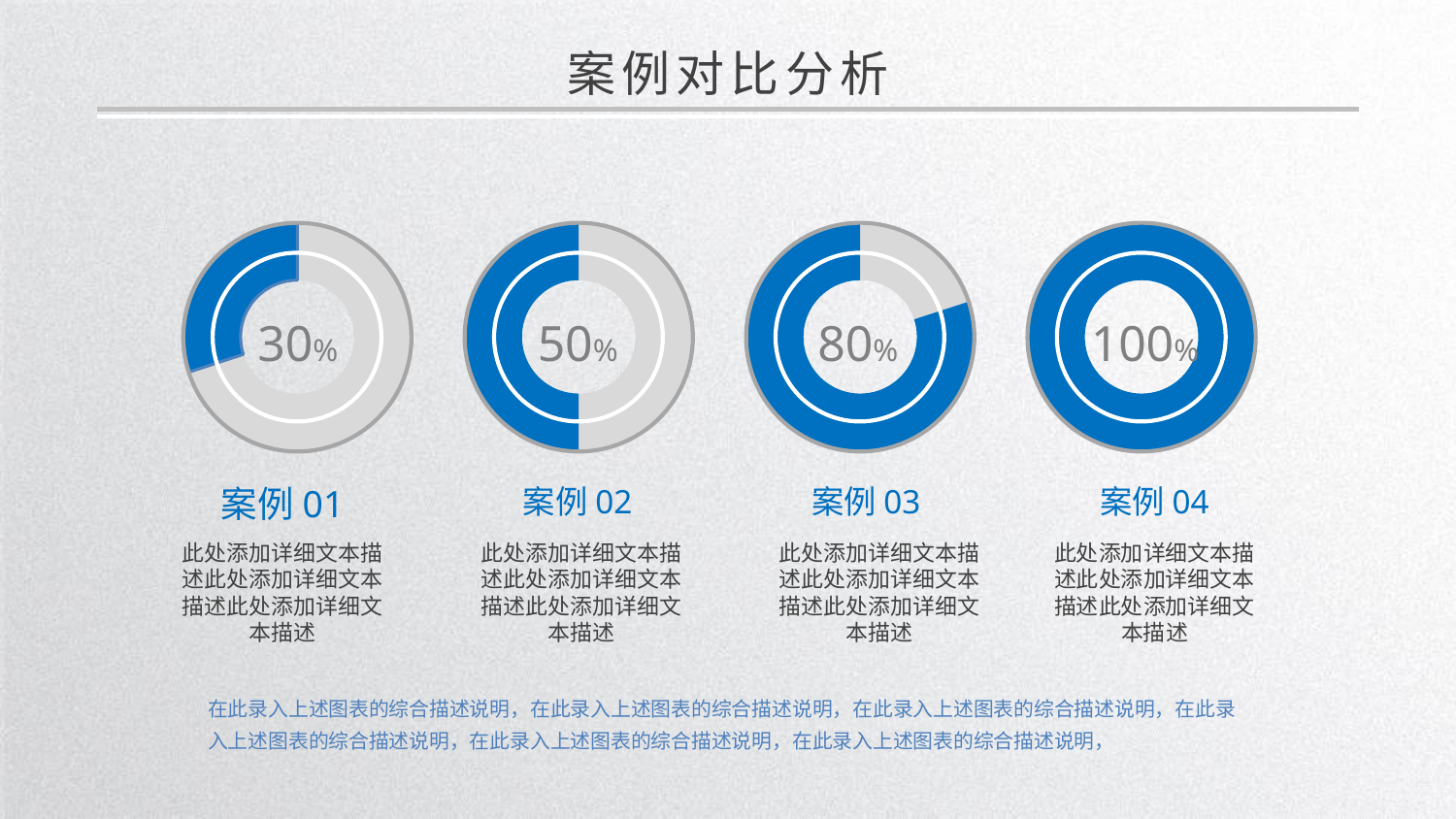
What value is shown in the donut chart for 案例 04? 100% What value is shown in the donut chart for 案例 03? 80% What is the title of the slide containing the four donut charts? 案例对比分析 How many donut charts are shown on the slide? 4 What value is shown in the donut chart for 案例 02? 50% Which case (案例) has the lowest percentage among the four donut charts? 案例 01 What is the difference between the percentage for 案例 04 and the percentage for 案例 02? 50% Which case (案例) has the highest percentage among the four donut charts? 案例 04 What value is shown in the donut chart for 案例 01? 30% Which has a larger percentage, 案例 02 or 案例 03? 案例 03 What is the difference between the percentage for 案例 03 and the percentage for 案例 01? 50% What kind of chart is used to show each case's percentage on the slide? Donut chart